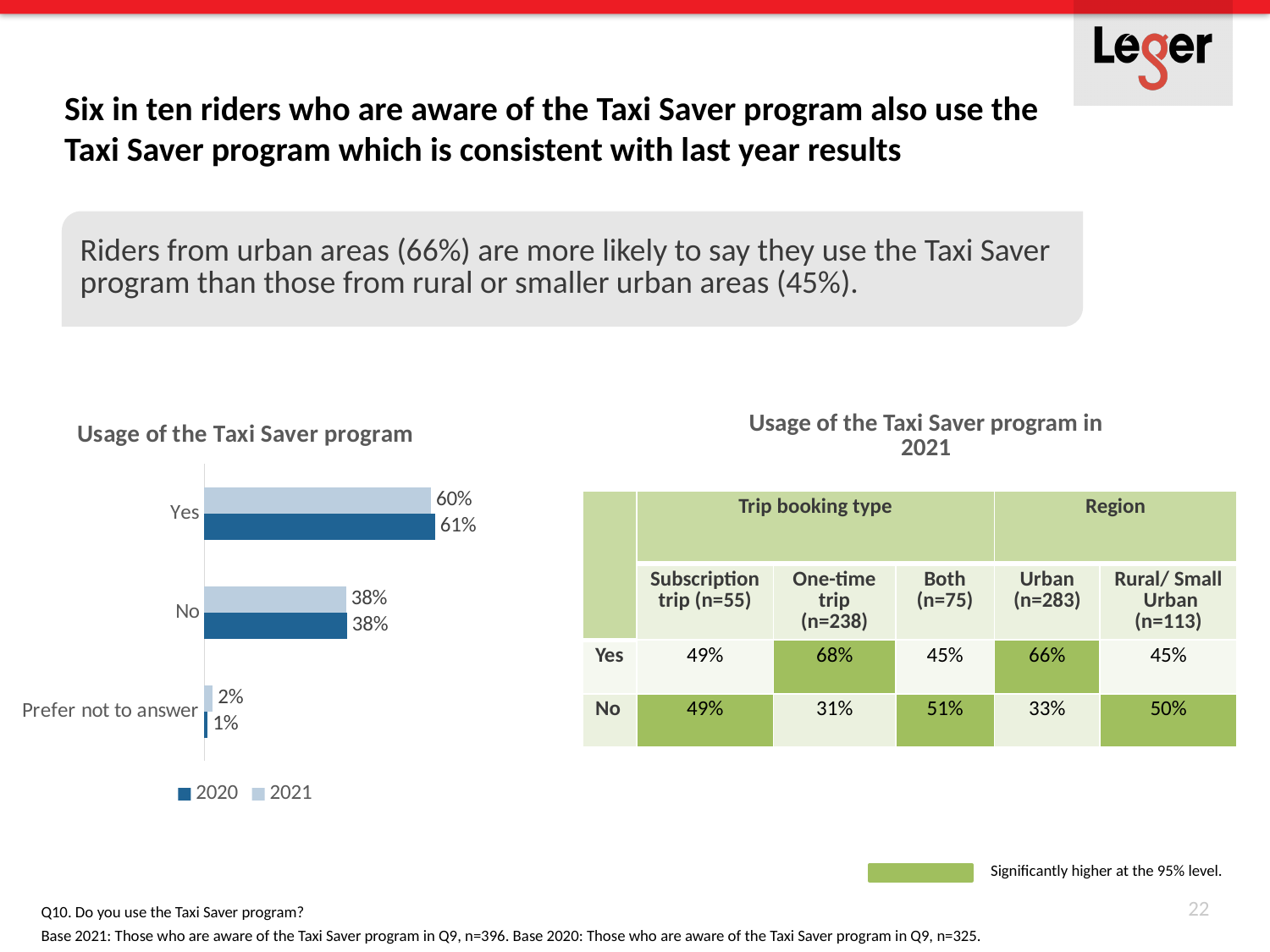
In the chart 'Usage of the Taxi Saver program', which category has the lowest value for 2020? Prefer not to answer In the chart 'Usage of the Taxi Saver program', how many series does the legend list? 2 In the chart 'Usage of the Taxi Saver program', which category has the highest value for 2021? Yes In the chart 'Usage of the Taxi Saver program', what is the value for 'No' in 2021? 38% In the chart 'Usage of the Taxi Saver program', what is the value for 'Prefer not to answer' in 2020? 1% In the chart 'Usage of the Taxi Saver program', what is the difference between the 'Yes' and 'No' values for 2021? 22% In the chart 'Usage of the Taxi Saver program', what is the value for 'Yes' in 2021? 60% In the chart 'Usage of the Taxi Saver program', what is the value for 'Yes' in 2020? 61% In the chart 'Usage of the Taxi Saver program', what is the value for 'Prefer not to answer' in 2021? 2% In the chart 'Usage of the Taxi Saver program', how many categories are shown? 3 What type of chart is 'Usage of the Taxi Saver program'? Bar chart In the chart 'Usage of the Taxi Saver program', what is the difference between the 2020 and 2021 values for 'Yes'? 1%